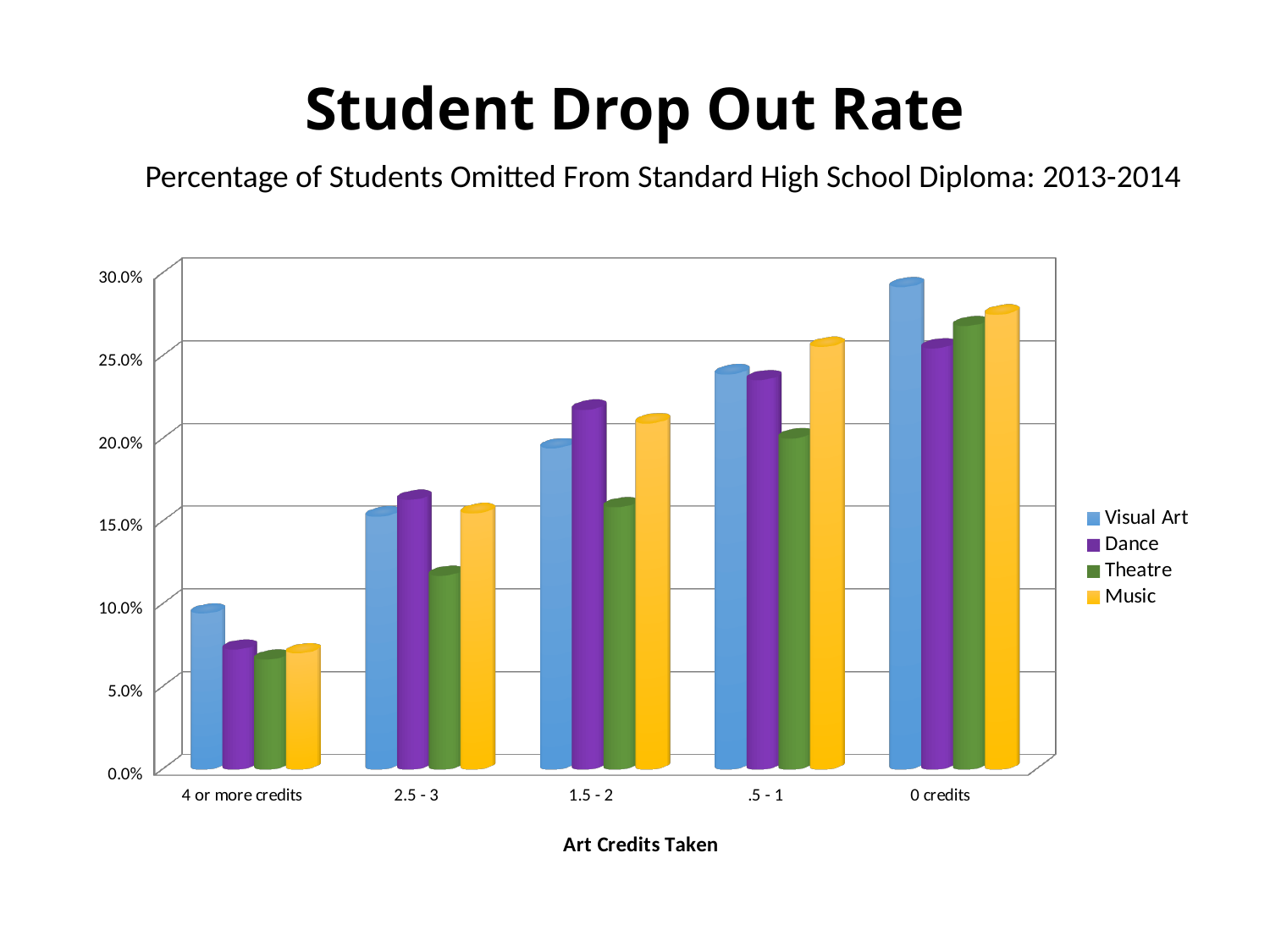
In the .5 - 1 category, which is larger, Music or Theatre? Music How many series does the legend list? 4 Is the value for Music at 4 or more credits greater or less than 10.0%? less In the 1.5 - 2 category, which is larger, Dance or Theatre? Dance How many categories are shown along the x axis of the chart? 5 Which category has the lowest value for Theatre? 4 or more credits Which category has the highest value for Visual Art? 0 credits Do the Visual Art values rise or fall moving from 4 or more credits to 0 credits along the x axis? rise Is the value for Visual Art at 0 credits greater or less than 25.0%? greater What kind of chart is shown on the slide? bar chart Is the value for Theatre at 2.5 - 3 credits greater or less than 15.0%? less What is the title of the x axis? Art Credits Taken